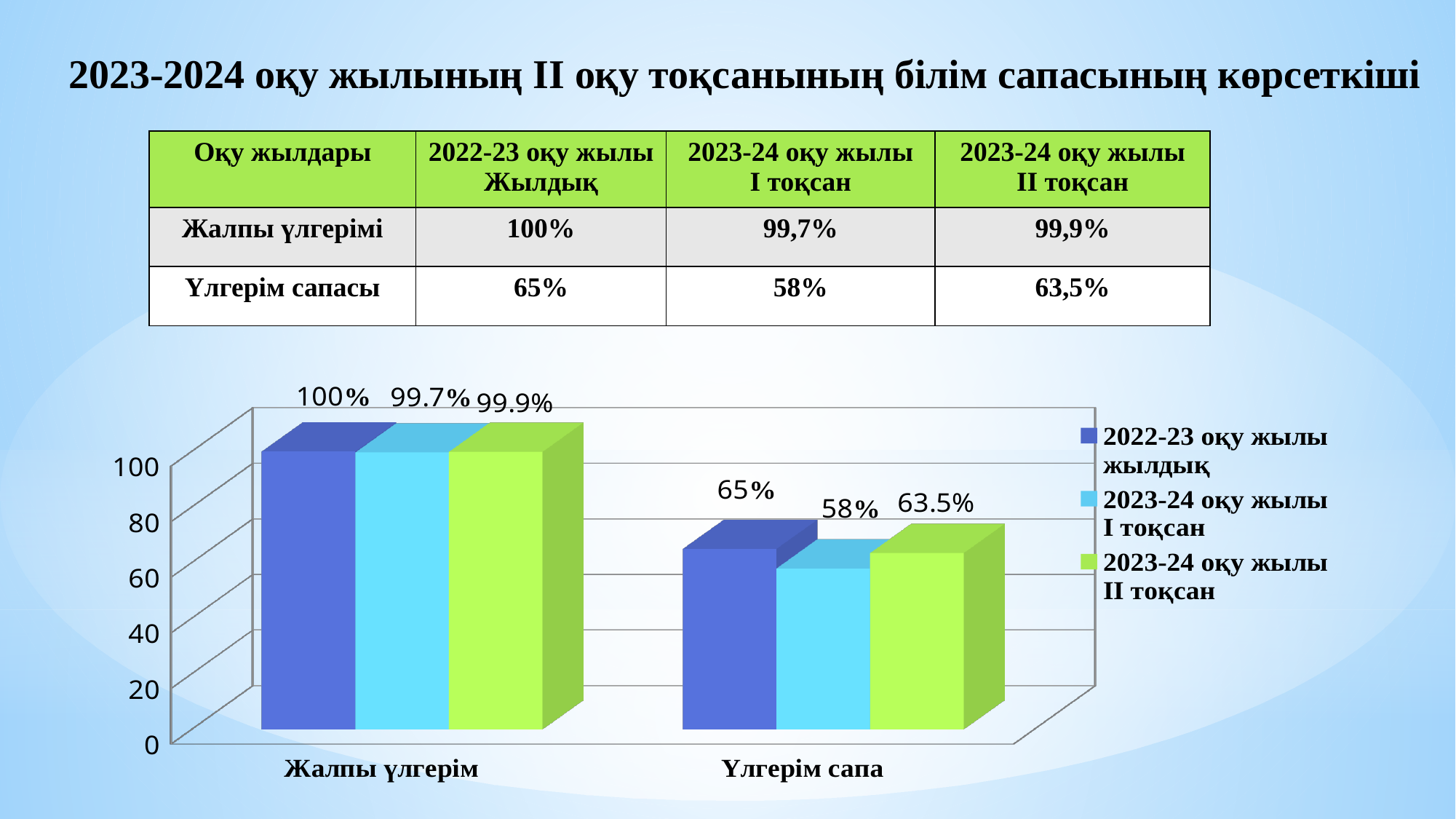
Which series has the lowest value for Үлгерім сапа? 2023-24 оқу жылы I тоқсан What is the difference between the 2022-23 оқу жылы жылдық and 2023-24 оқу жылы I тоқсан values for Үлгерім сапа? 7% Which series has the highest value for Үлгерім сапа? 2022-23 оқу жылы жылдық What type of chart is shown on the slide? bar chart What is the value for Үлгерім сапа in the 2023-24 оқу жылы II тоқсан series? 63.5% How many categories are shown on the x axis of the chart? 2 What is the value for Үлгерім сапа in the 2023-24 оқу жылы I тоқсан series? 58% Which legend entry is shown in green? 2023-24 оқу жылы II тоқсан What is the value for Жалпы үлгерім in the 2022-23 оқу жылы жылдық series? 100% What is the value for Жалпы үлгерім in the 2023-24 оқу жылы I тоқсан series? 99.7% How many series does the chart legend list? 3 For the 2023-24 оқу жылы II тоқсан series, which category has the larger value, Жалпы үлгерім or Үлгерім сапа? Жалпы үлгерім